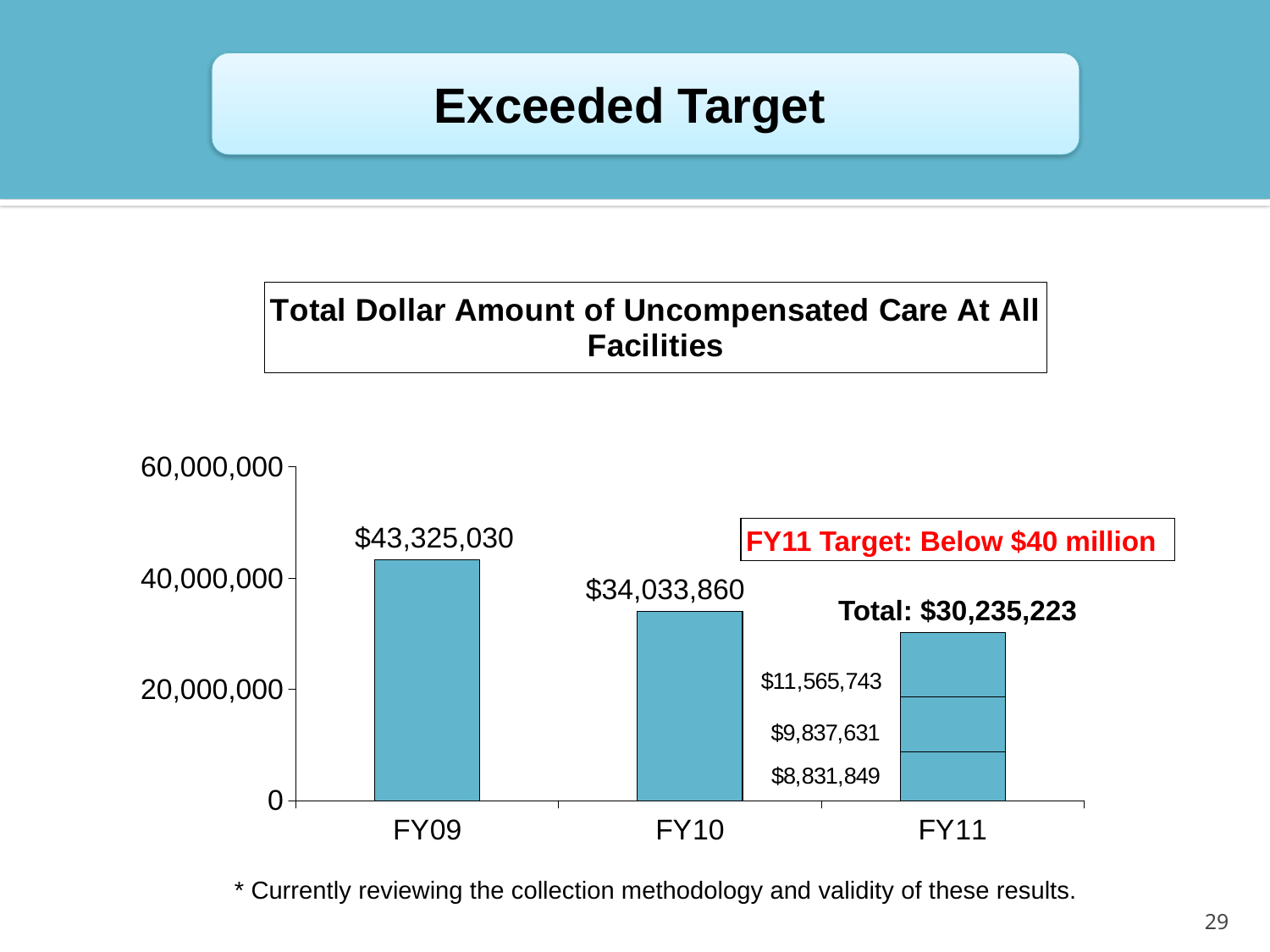
What is the largest segment value shown in the FY11 stacked bar? $11,565,743 What is the value for FY09? $43,325,030 Which is larger, the value for FY10 or the total for FY11? FY10 What is the difference between the FY09 and FY10 values? $9,291,170 How many fiscal years are shown on the x axis? 3 What is the value for FY10? $34,033,860 What is the total of the FY11 stacked bar? $30,235,223 Is the total for FY11 greater or less than 40,000,000? less Which fiscal year has the lowest total dollar amount of uncompensated care? FY11 What kind of chart is shown on the slide? bar chart Which fiscal year has the highest total dollar amount of uncompensated care? FY09 Do the values rise or fall from FY09 to FY11? fall